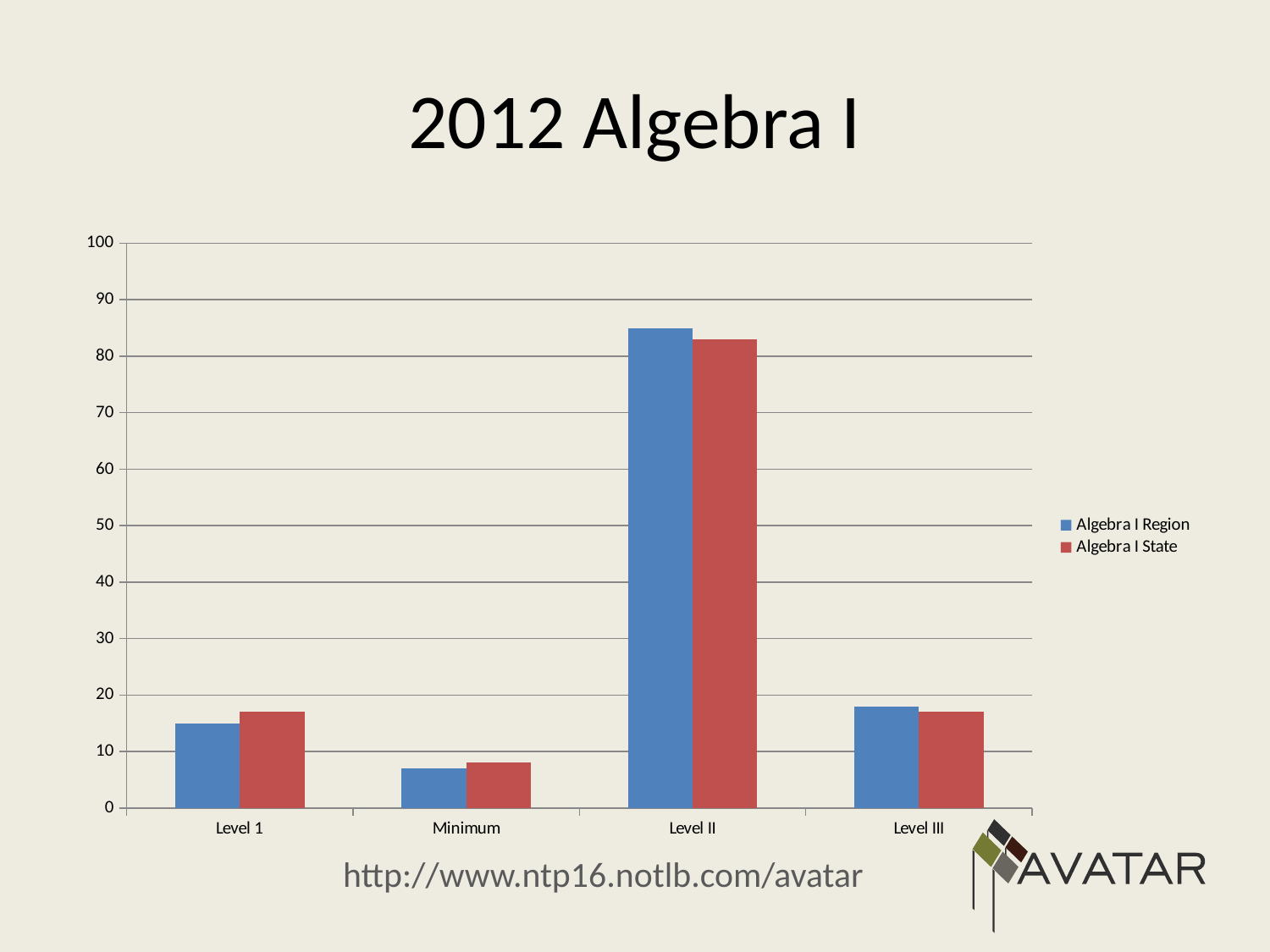
Is the value for Algebra I Region at Minimum greater or less than 10? less Is the value for Algebra I State at Level 1 greater or less than 20? less How many series does the legend list? 2 Which category has the lowest value for Algebra I State? Minimum At Level II, which series has the larger value, Algebra I Region or Algebra I State? Algebra I Region Which category has the highest value for Algebra I Region? Level II What kind of chart is shown on the slide? bar chart What colour are the bars for the Algebra I State series? red What is the title of the chart? 2012 Algebra I How many categories are shown on the x axis? 4 Is the value for Algebra I Region at Level II greater or less than 80? greater Which category has the lowest value for Algebra I Region? Minimum